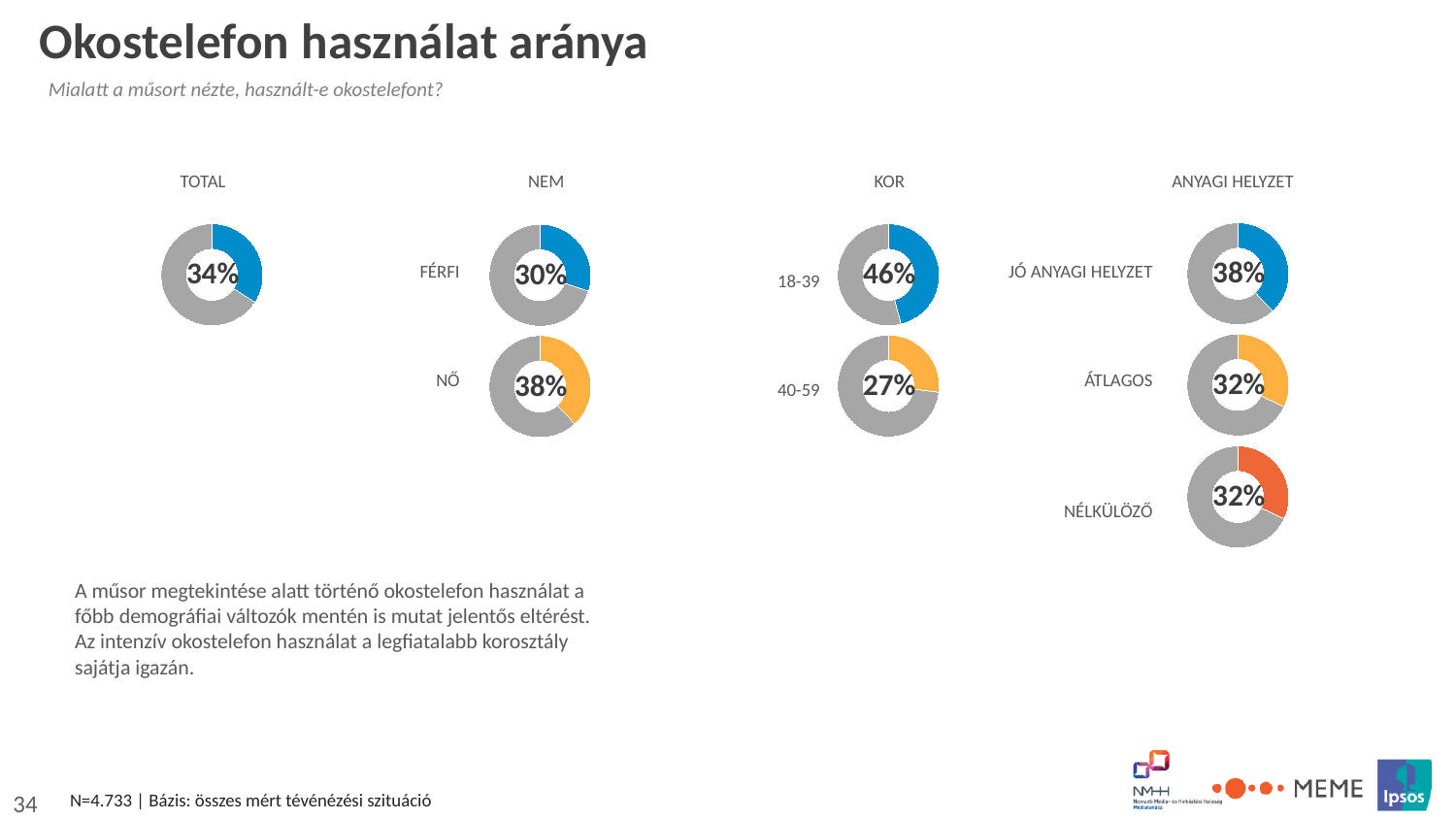
In the KOR (age) charts, which age group has the higher smartphone usage share? 18-39 In the ANYAGI HELYZET charts, what is the value for NÉLKÜLÖZŐ? 32% In the TOTAL donut chart, what share of viewers used a smartphone while watching? 34% What type of chart is used to show the values on this slide? Donut (pie) chart In the NEM (gender) charts, what is the value for NŐ? 38% In the KOR (age) charts, what is the difference between the 18-39 and 40-59 values? 19 percentage points In the KOR (age) charts, what is the value for the 40-59 group? 27% In the ANYAGI HELYZET charts, what is the value for JÓ ANYAGI HELYZET? 38% Across all the charts on the slide, which group has the lowest smartphone usage share? 40-59 In the NEM (gender) charts, what is the difference between the NŐ and FÉRFI values? 8 percentage points In the KOR (age) charts, what is the value for the 18-39 group? 46% In the NEM (gender) charts, what is the value for FÉRFI? 30%